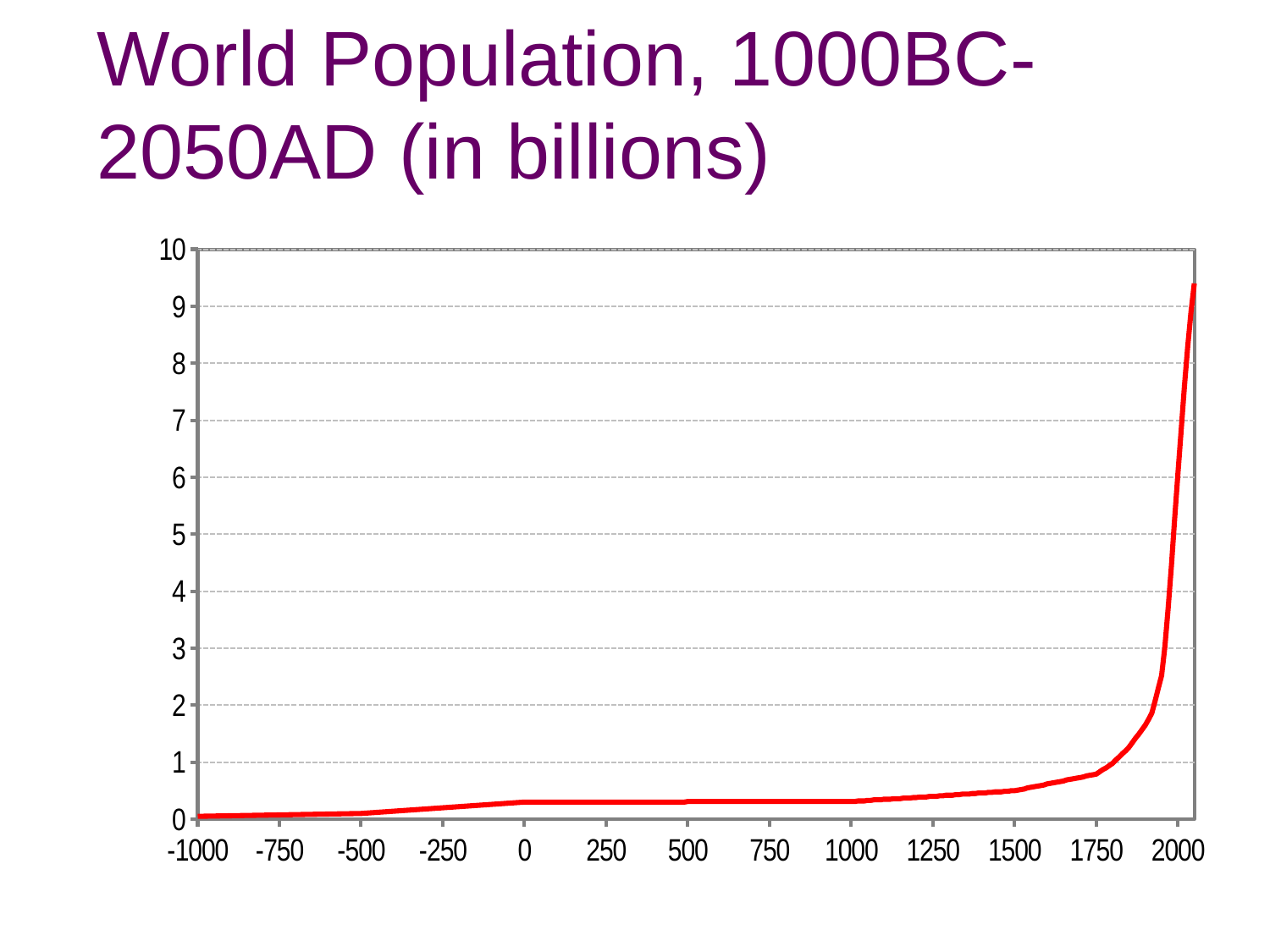
What colour is the plotted line? red Is the value at the right end of the line (2050) greater or less than 8? greater Is the value for the year 1500 greater or less than 1? less Is the value for the year 2000 greater or less than 5? greater How many labelled tick marks are on the x axis? 13 What kind of chart is shown on the slide? line chart What is the title of the chart? World Population, 1000BC-2050AD (in billions) Does the world population rise or fall as the years increase along the x axis? rise Is the line at its highest at the left end or the right end of the x axis? right end